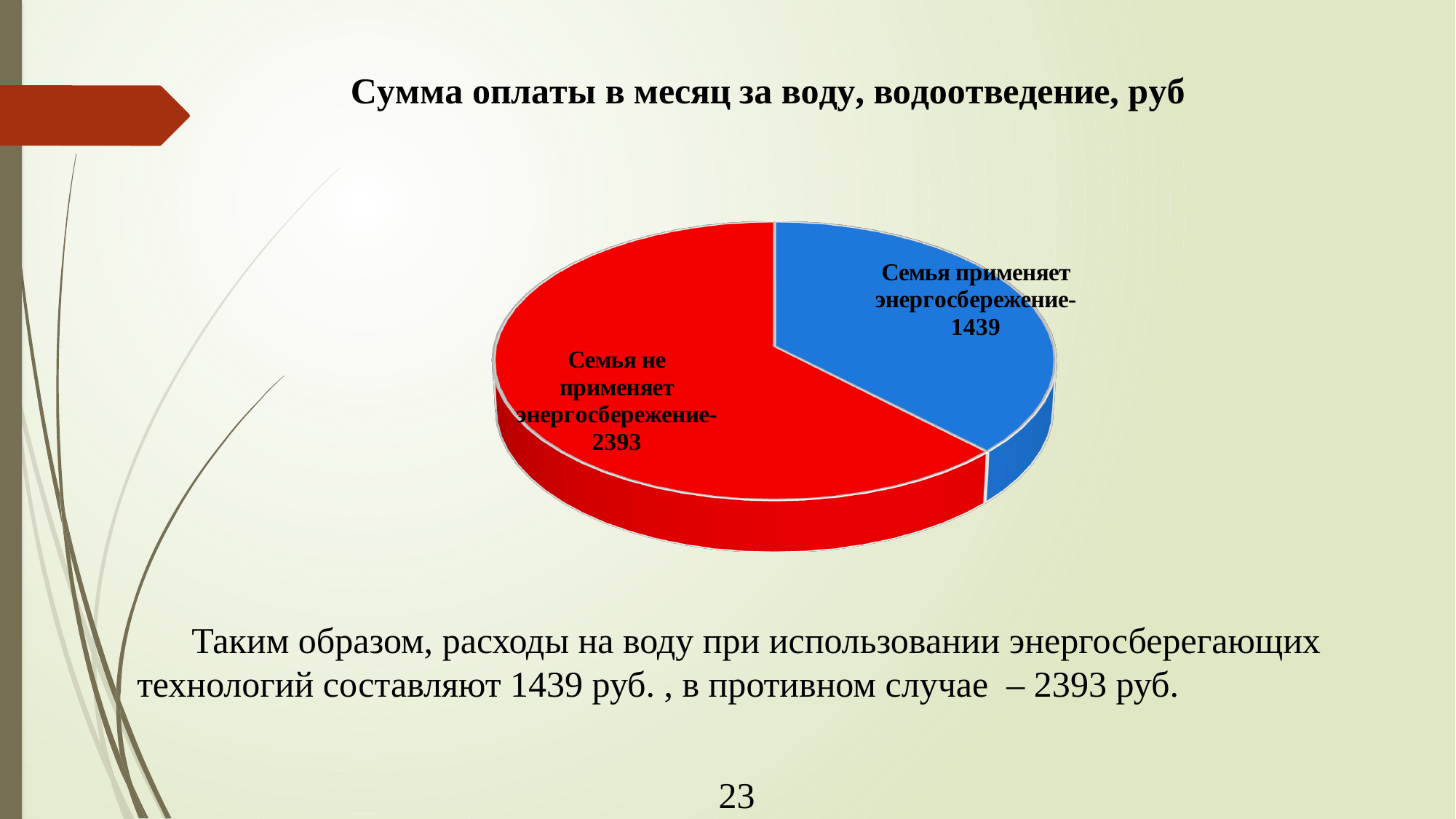
What is the value for the slice 'Семья применяет энергосбережение'? 1439 Which category has the largest slice of the pie? Семья не применяет энергосбережение What type of chart is shown on the slide? pie chart Which category has the smallest slice of the pie? Семья применяет энергосбережение What is the value for the slice 'Семья не применяет энергосбережение'? 2393 How many slices does the pie chart have? 2 What is the difference between the value for 'Семья не применяет энергосбережение' and the value for 'Семья применяет энергосбережение'? 954 What is the title of the chart? Сумма оплаты в месяц за воду, водоотведение, руб Which is larger: the value for 'Семья применяет энергосбережение' or the value for 'Семья не применяет энергосбережение'? Семья не применяет энергосбережение What colour is the slice for 'Семья применяет энергосбережение'? blue What is the total of the two values shown in the pie chart? 3832